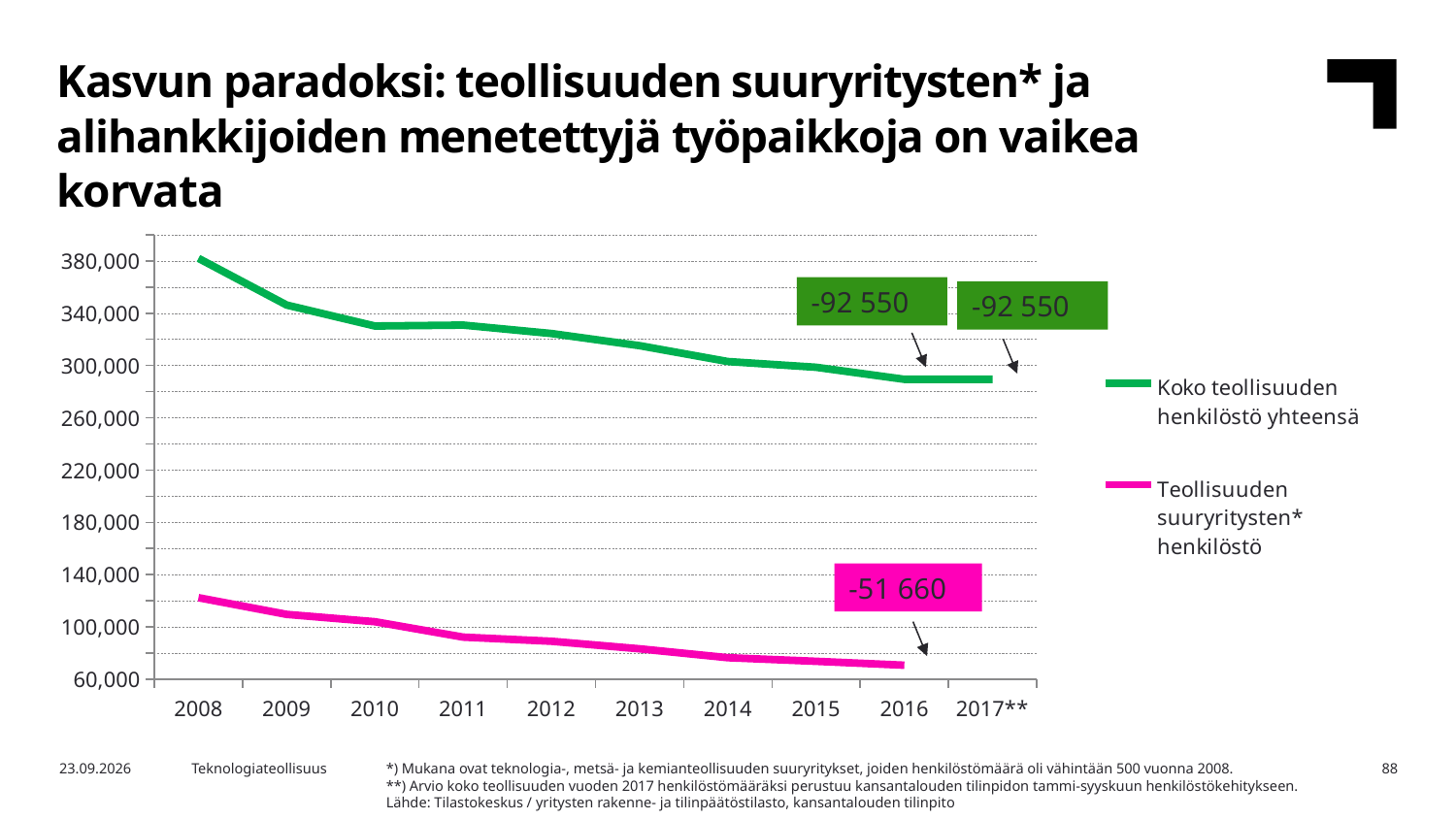
Is the value for 'Koko teollisuuden henkilöstö yhteensä' in 2016 greater or less than 300,000? less What change is shown in the annotation box pointing to the 'Teollisuuden suuryritysten* henkilöstö' line? -51 660 How many years are shown on the x axis? 10 What kind of chart is shown on the slide? line chart In which year is 'Teollisuuden suuryritysten* henkilöstö' highest? 2008 Is the value for 'Teollisuuden suuryritysten* henkilöstö' in 2016 greater or less than 100,000? less In which year is 'Koko teollisuuden henkilöstö yhteensä' highest? 2008 Which series has the higher value in 2014, 'Koko teollisuuden henkilöstö yhteensä' or 'Teollisuuden suuryritysten* henkilöstö'? Koko teollisuuden henkilöstö yhteensä Does the 'Teollisuuden suuryritysten* henkilöstö' line rise or fall from 2008 to 2016? fall How many series does the legend list? 2 Does the 'Koko teollisuuden henkilöstö yhteensä' line rise or fall from 2008 to 2016? fall Is the value for 'Teollisuuden suuryritysten* henkilöstö' in 2008 greater or less than 100,000? greater